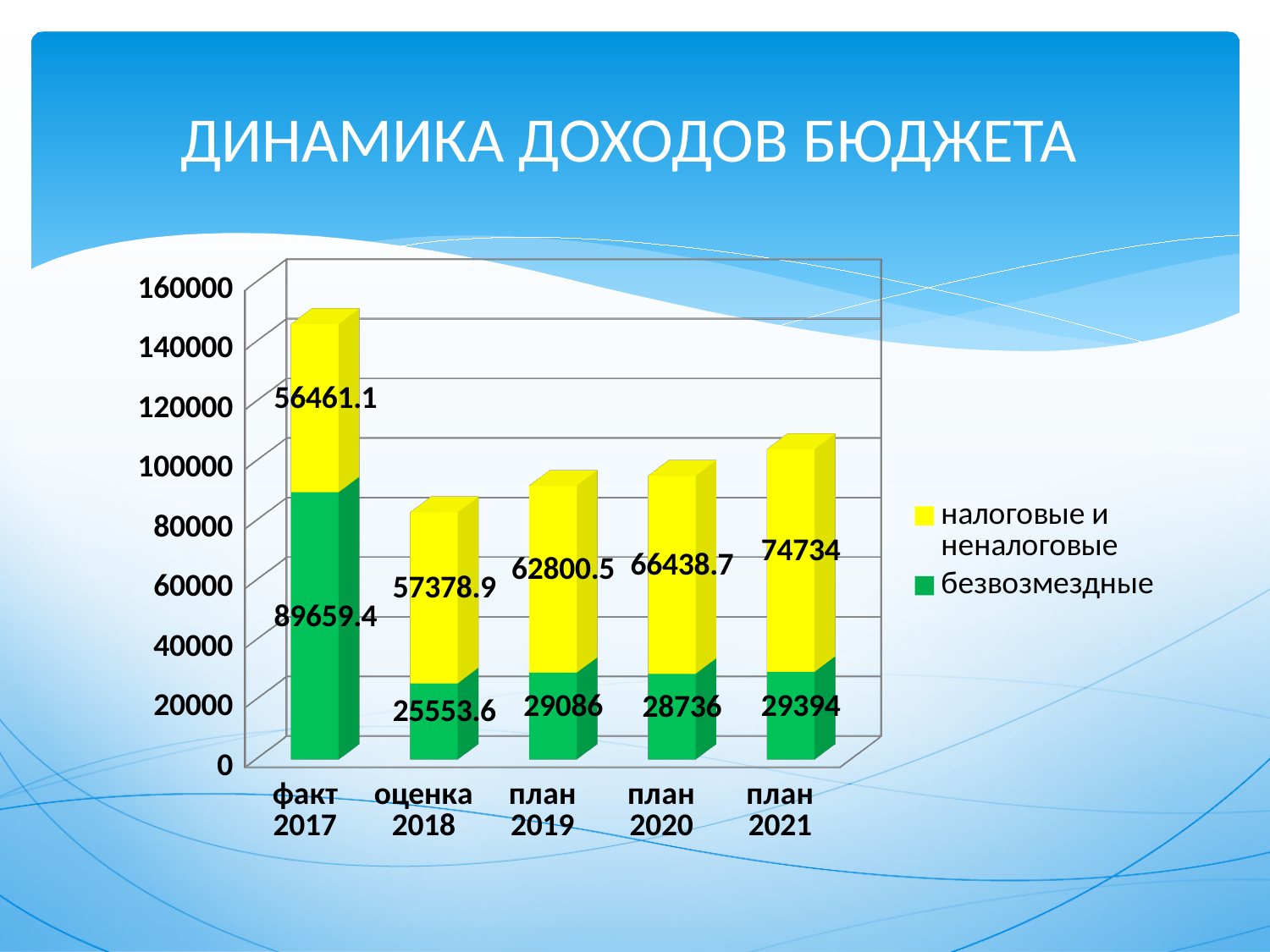
How many categories are shown on the x axis? 5 How many series does the legend list? 2 What kind of chart is shown on the slide? Stacked bar chart What is the value of налоговые и неналоговые for план 2021? 74734 What is the difference between the налоговые и неналоговые values for план 2021 and план 2020? 8295.3 What is the total of the stacked bar for план 2021? 104128 What is the value of налоговые и неналоговые for оценка 2018? 57378.9 What is the value of безвозмездные for факт 2017? 89659.4 Which category has the highest value for безвозмездные? факт 2017 Which is larger: безвозмездные for план 2019 or for план 2020? план 2019 Which category has the lowest value for налоговые и неналоговые? факт 2017 What is the total of the stacked bar for оценка 2018? 82932.5